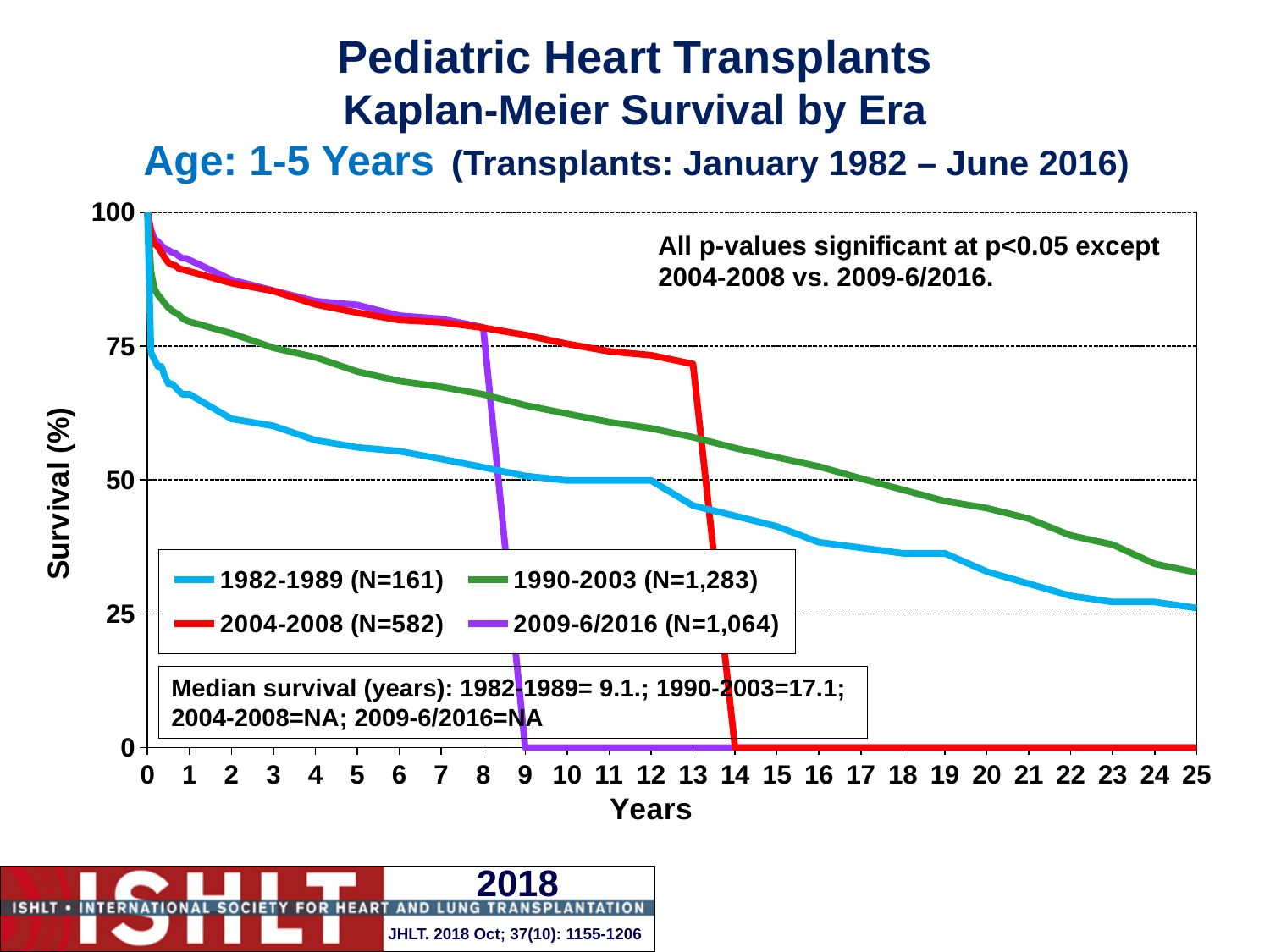
Is the survival for the 1982-1989 era at 5 years greater or less than 50? greater What is the N for the 1990-2003 era shown in the legend? 1,283 What is the median survival in years for the 1982-1989 era? 9.1 How many eras (series) does the legend list? 4 Do the survival curves rise or fall as years increase? fall What is the N for the 2009-6/2016 era shown in the legend? 1,064 At 5 years, which era has higher survival: 1982-1989 or 1990-2003? 1990-2003 Which era has the smallest number of transplants (N) in the legend? 1982-1989 What kind of chart is shown on the slide? Line chart Is the survival for the 1990-2003 era at 25 years greater or less than 25? greater What is the median survival in years for the 1990-2003 era? 17.1 Which era has the largest number of transplants (N) in the legend? 1990-2003